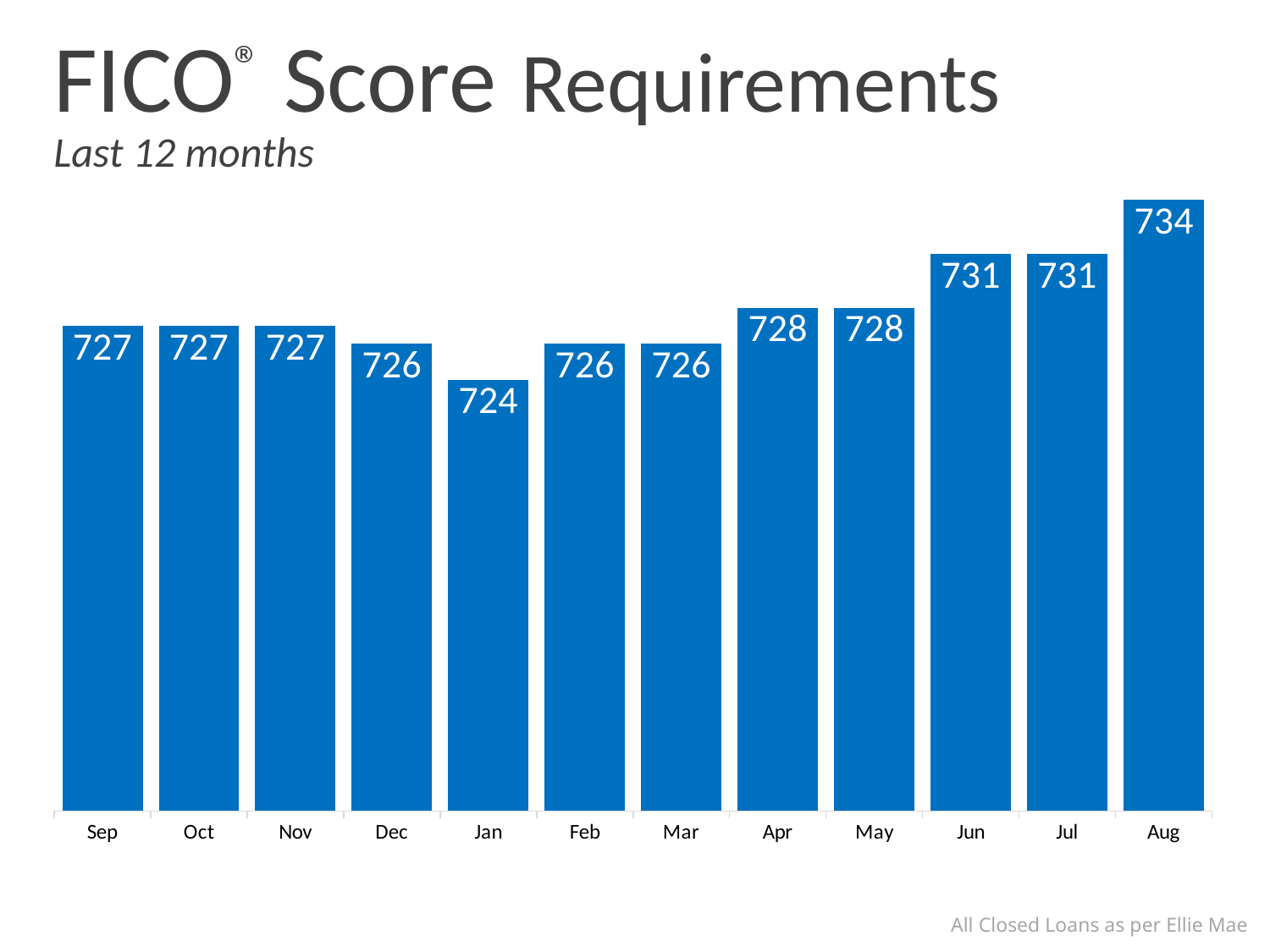
What is the FICO score value for Jan? 724 What is the FICO score value for Aug? 734 How many months are shown on the chart? 12 Do the values generally rise or fall from Jan to Aug? Rise Which month has the highest FICO score value? Aug Which is larger, the value for May or the value for Jul? Jul What kind of chart is shown on the slide? Bar chart What is the FICO score value for Apr? 728 What is the difference between the values for Jun and Dec? 5 Which month has the lowest FICO score value? Jan What is the title of the chart? FICO Score Requirements What is the difference between the values for Aug and Jan? 10